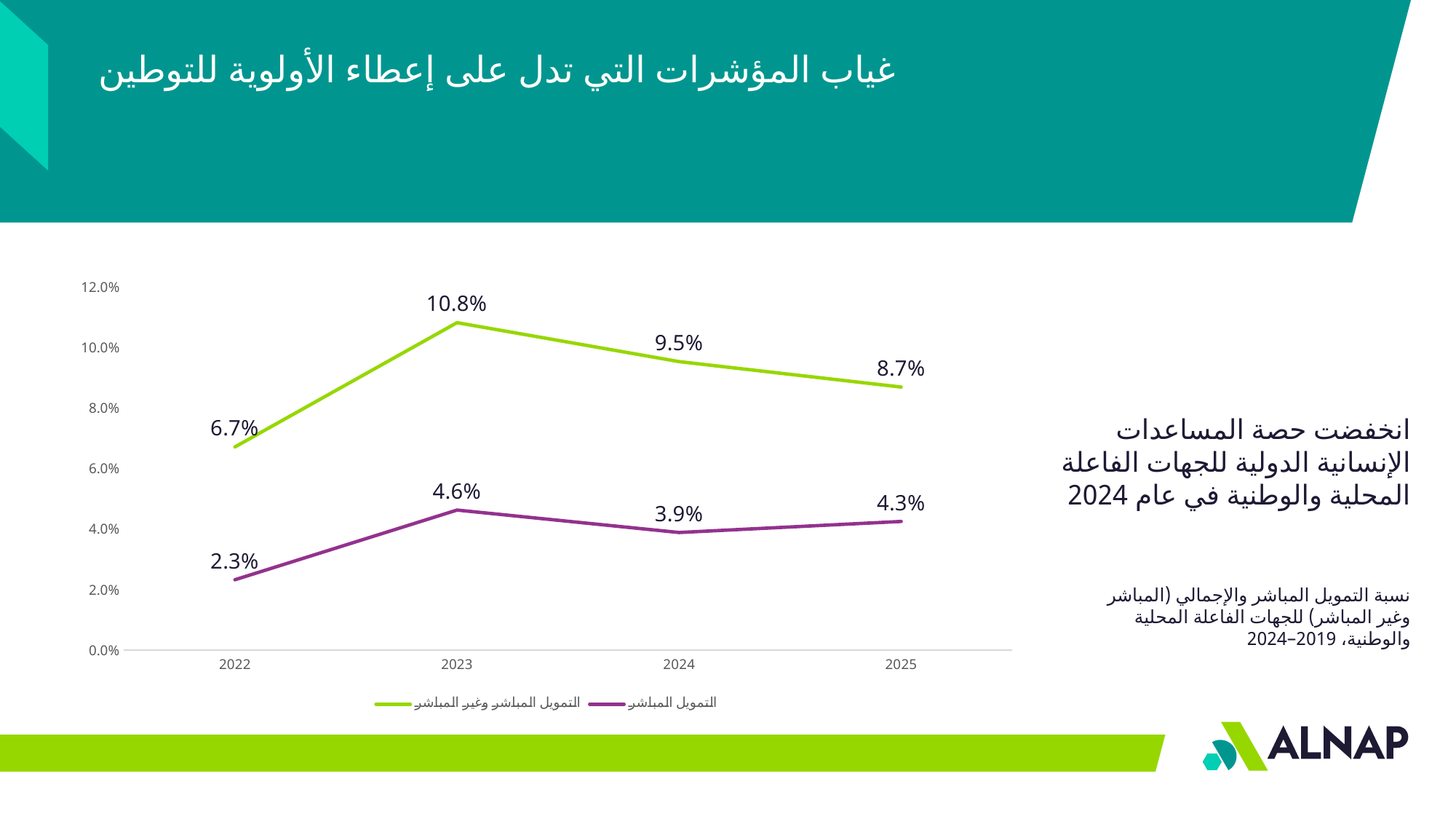
Which is larger: the purple line's value in 2024 or in 2025? 2025 What is the value of the purple line (التمويل المباشر) in 2025? 4.3% In which year does the green line (التمويل المباشر وغير المباشر) reach its highest value? 2023 How many series does the legend list? 2 By how much did the green line (التمويل المباشر وغير المباشر) fall from 2023 to 2025? 2.1% What kind of chart is shown on the slide? Line chart What is the value of the purple line (التمويل المباشر) in 2022? 2.3% Does the green line (التمويل المباشر وغير المباشر) rise or fall from 2023 to 2025? Fall What is the value of the green line (التمويل المباشر وغير المباشر) in 2023? 10.8% In which year is the purple line (التمويل المباشر) at its lowest value? 2022 How many years are shown on the x axis? 4 What is the difference between the green line and the purple line in 2024? 5.6%